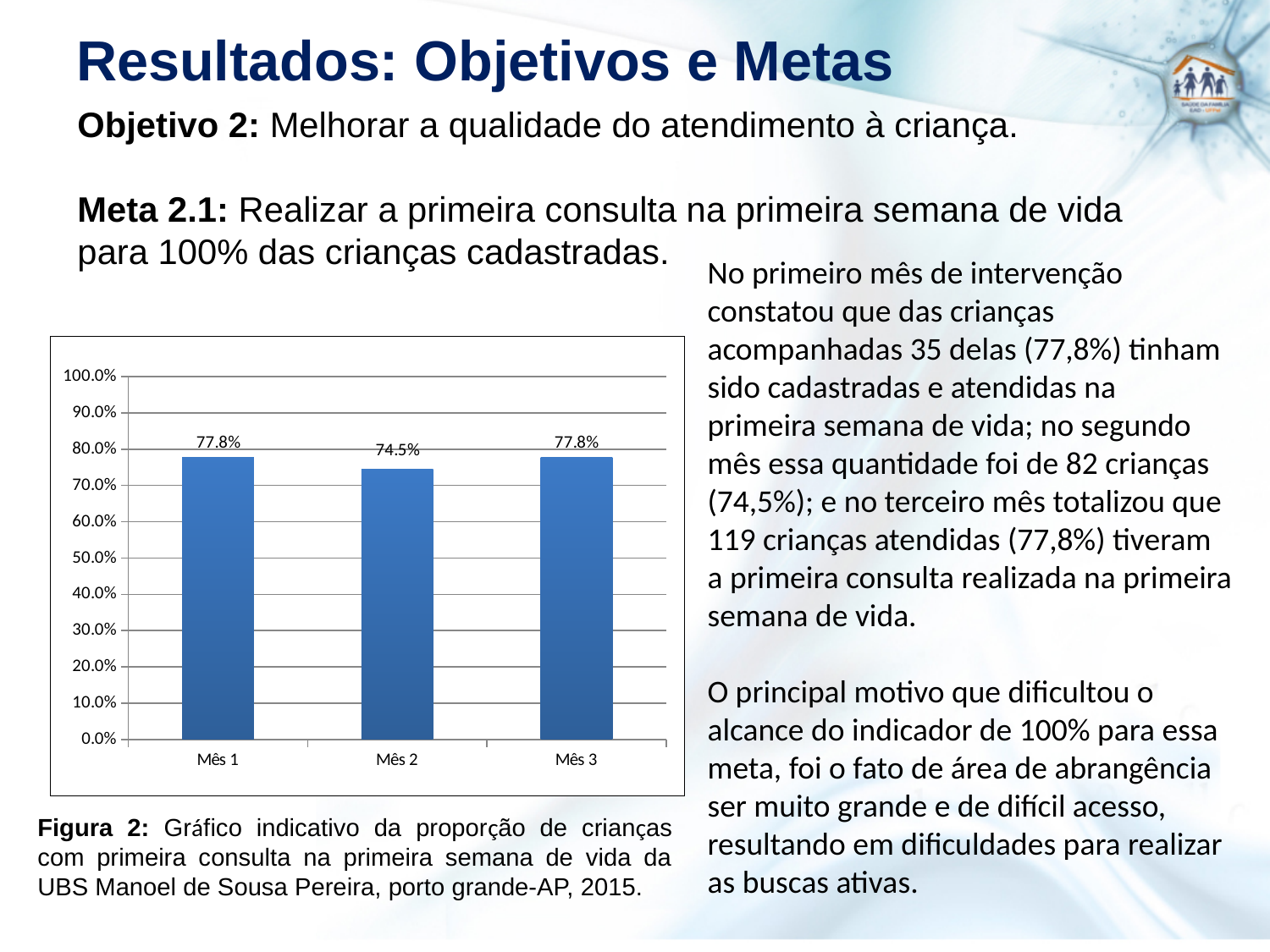
What is the value for Mês 2? 74.5% What is the value for Mês 1? 77.8% What kind of chart is shown on the slide? bar chart What is the figure number given in the caption below the chart? Figura 2 How many categories are shown on the x axis? 3 What is the value for Mês 3? 77.8% Which month has the lowest value? Mês 2 What is the highest value shown on the y axis? 100.0% Is the value for Mês 2 greater or less than 80.0%? less What is the difference between the values for Mês 1 and Mês 2? 3.3% Is the value for Mês 1 greater or less than 70.0%? greater Which is larger, the value for Mês 2 or the value for Mês 3? Mês 3